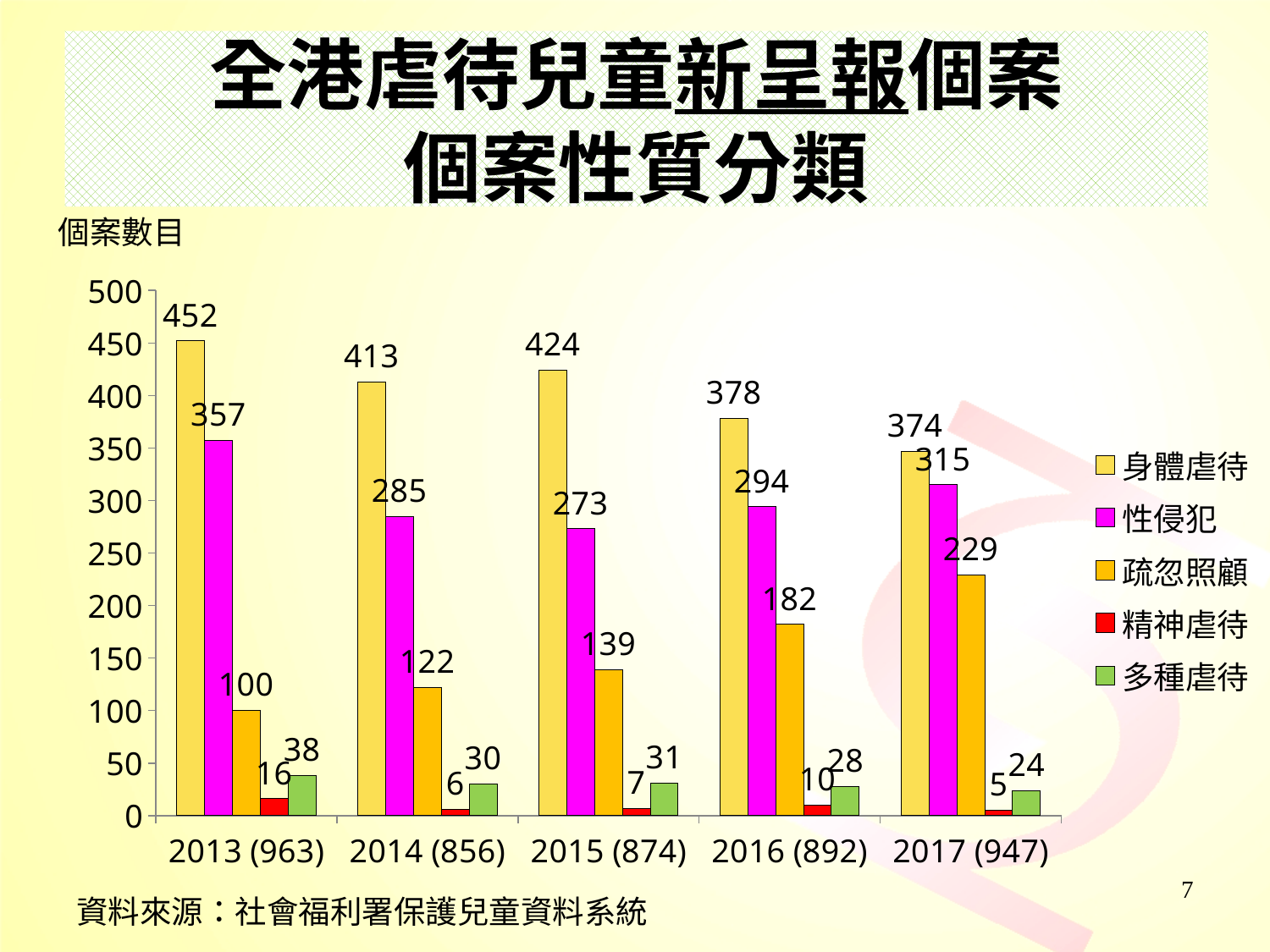
Which is larger: 性侵犯 in 2014 (856) or 性侵犯 in 2015 (874)? 2014 (856) Does the value for 疏忽照顧 rise or fall from 2014 (856) to 2017 (947)? rise How many series does the legend list? 5 What is the value for 疏忽照顧 in 2016 (892)? 182 What is the value for 性侵犯 in 2017 (947)? 315 What is the value for 精神虐待 in 2014 (856)? 6 How many year categories are shown on the x axis? 5 In which year is the value for 疏忽照顧 the lowest? 2013 (963) What is the difference between the 身體虐待 values for 2013 (963) and 2017 (947)? 78 In which year is the value for 身體虐待 the highest? 2013 (963) What is the value for 身體虐待 in 2013 (963)? 452 What type of chart is shown on the slide? bar chart